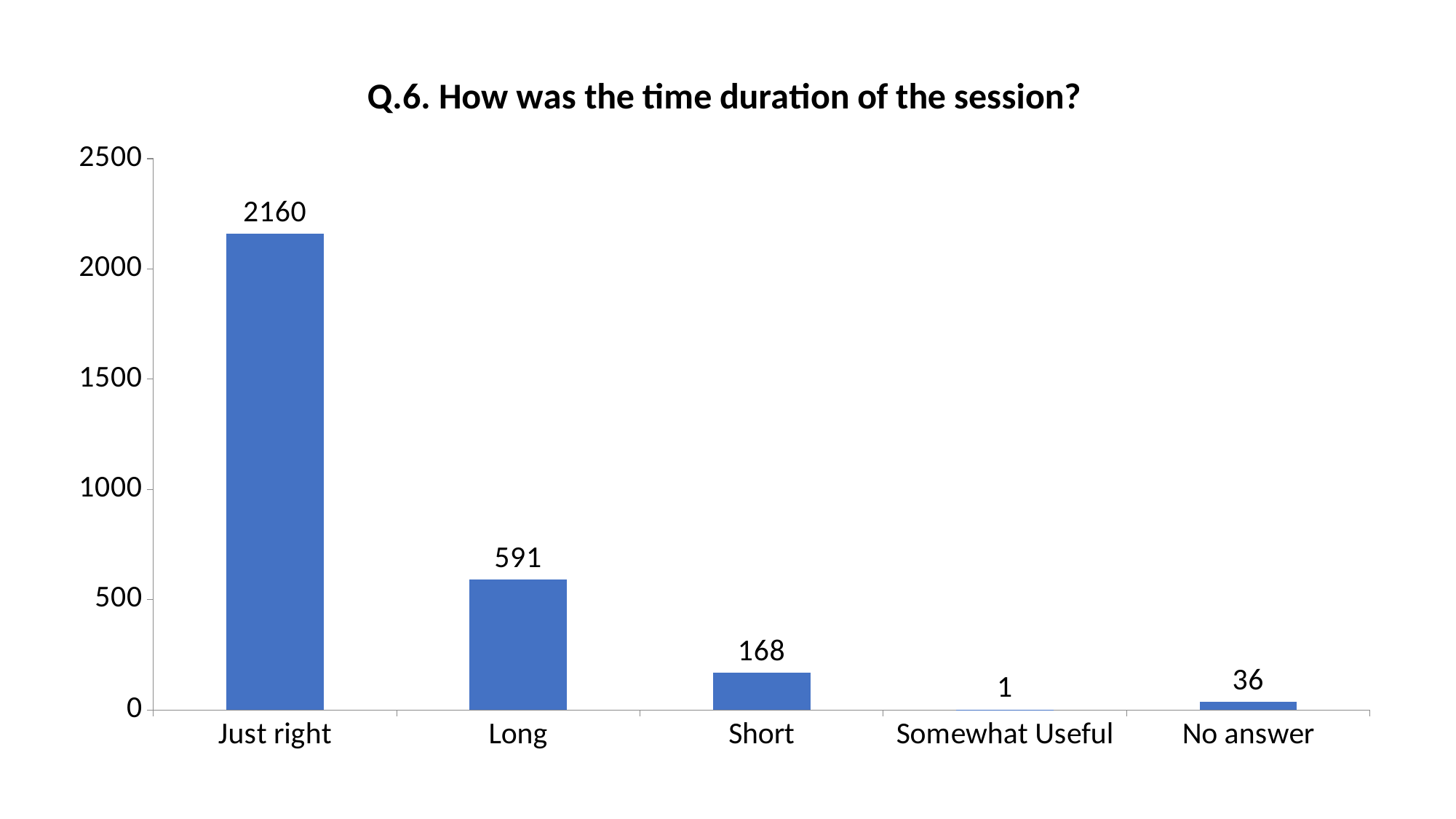
Which category has the highest value? Just right How many categories are shown on the x axis? 5 What is the value for Long? 591 What is the value for Somewhat Useful? 1 What kind of chart is this? bar chart What is the value for Just right? 2160 What is the value for Short? 168 Which category has the lowest value? Somewhat Useful Is the value for Long greater or less than 500? greater Which is larger, the value for Short or the value for No answer? Short What is the value for No answer? 36 What is the difference between the values for Just right and Long? 1569